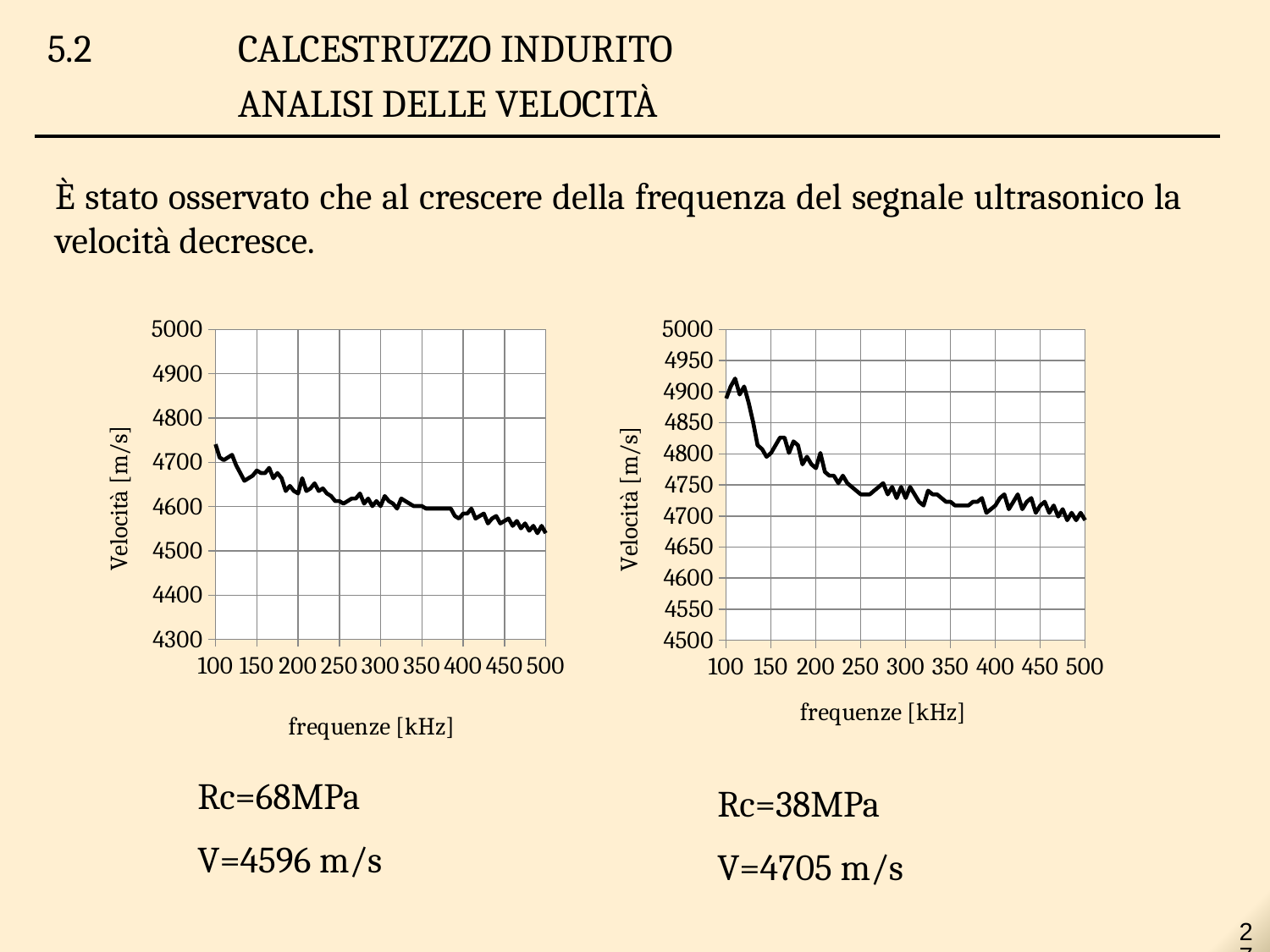
At 500 kHz, which chart shows the higher velocity, the left chart (Rc=68MPa) or the right chart (Rc=38MPa)? the right chart (Rc=38MPa) What is the x-axis label of the left chart (Rc=68MPa)? frequenze [kHz] In the left chart (Rc=68MPa), is the velocity at 100 kHz greater or less than 4700? greater In the left chart (Rc=68MPa), is the velocity at 500 kHz greater or less than 4600? less In the right chart (Rc=38MPa), is the velocity at 200 kHz greater or less than 4750? greater In the right chart (Rc=38MPa), do the velocity values rise or fall as frequency increases along the x axis? fall What kind of chart is the left chart (Rc=68MPa)? line chart In the left chart (Rc=68MPa), do the velocity values rise or fall as frequency increases along the x axis? fall How many tick labels are shown on the x axis of the left chart (Rc=68MPa)? 9 What is the y-axis label of the right chart (Rc=38MPa)? Velocità [m/s]